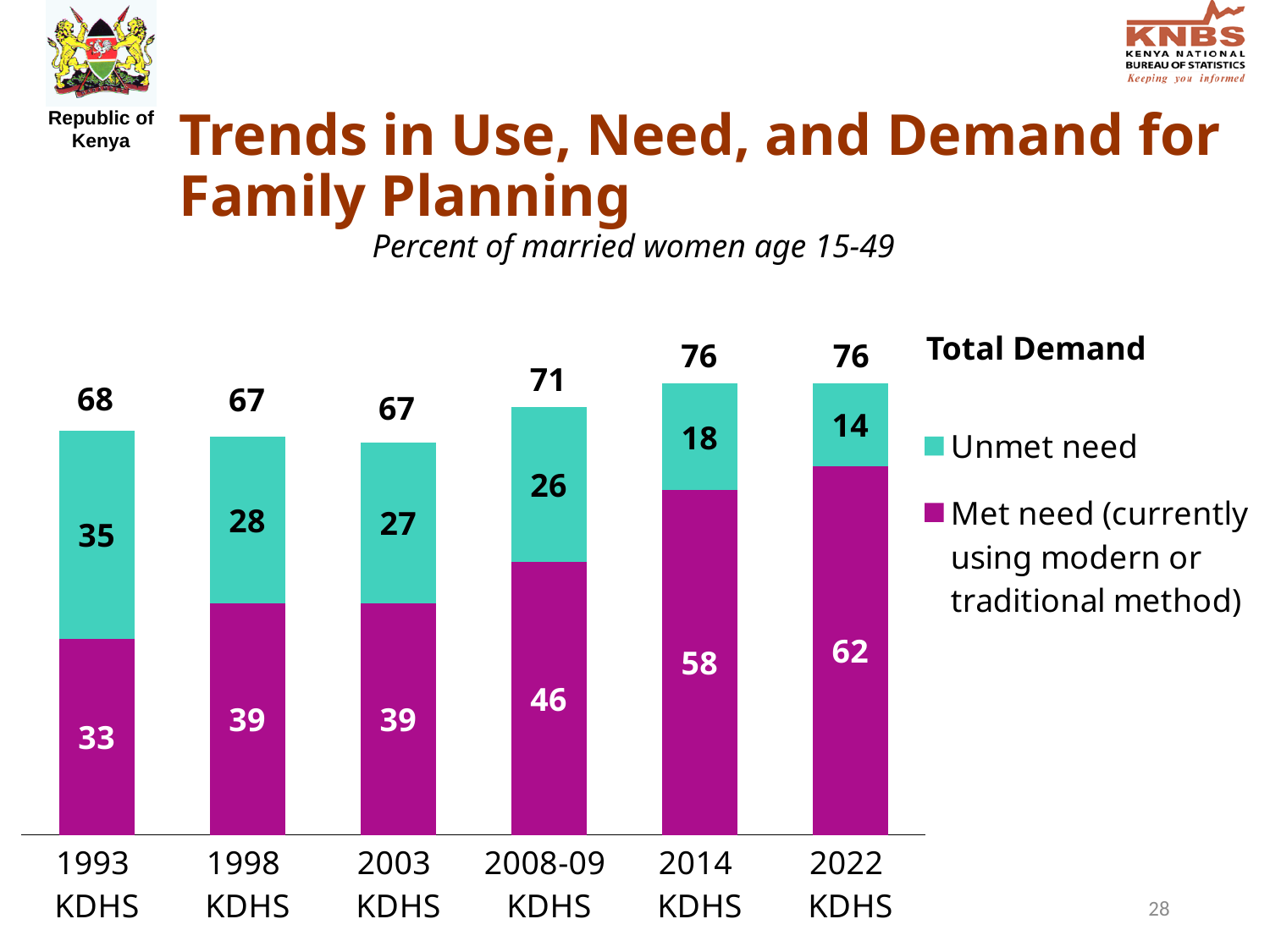
How many survey years are shown on the x axis? 6 What is the total demand shown for 2008-09 KDHS? 71 Which survey year has the highest unmet need? 1993 KDHS Does the met need rise or fall from 1993 KDHS to 2022 KDHS? Rise Which is larger, the unmet need in 2014 KDHS or in 2022 KDHS? 2014 KDHS What is the unmet need value for 1993 KDHS? 35 How many series does the legend list? 2 What is the difference between the met need in 2022 KDHS and in 1993 KDHS? 29 What is the met need value for 2014 KDHS? 58 What kind of chart is shown on the slide? Stacked bar chart Which survey year has the lowest met need? 1993 KDHS What is the total demand (met need plus unmet need) for 1998 KDHS? 67